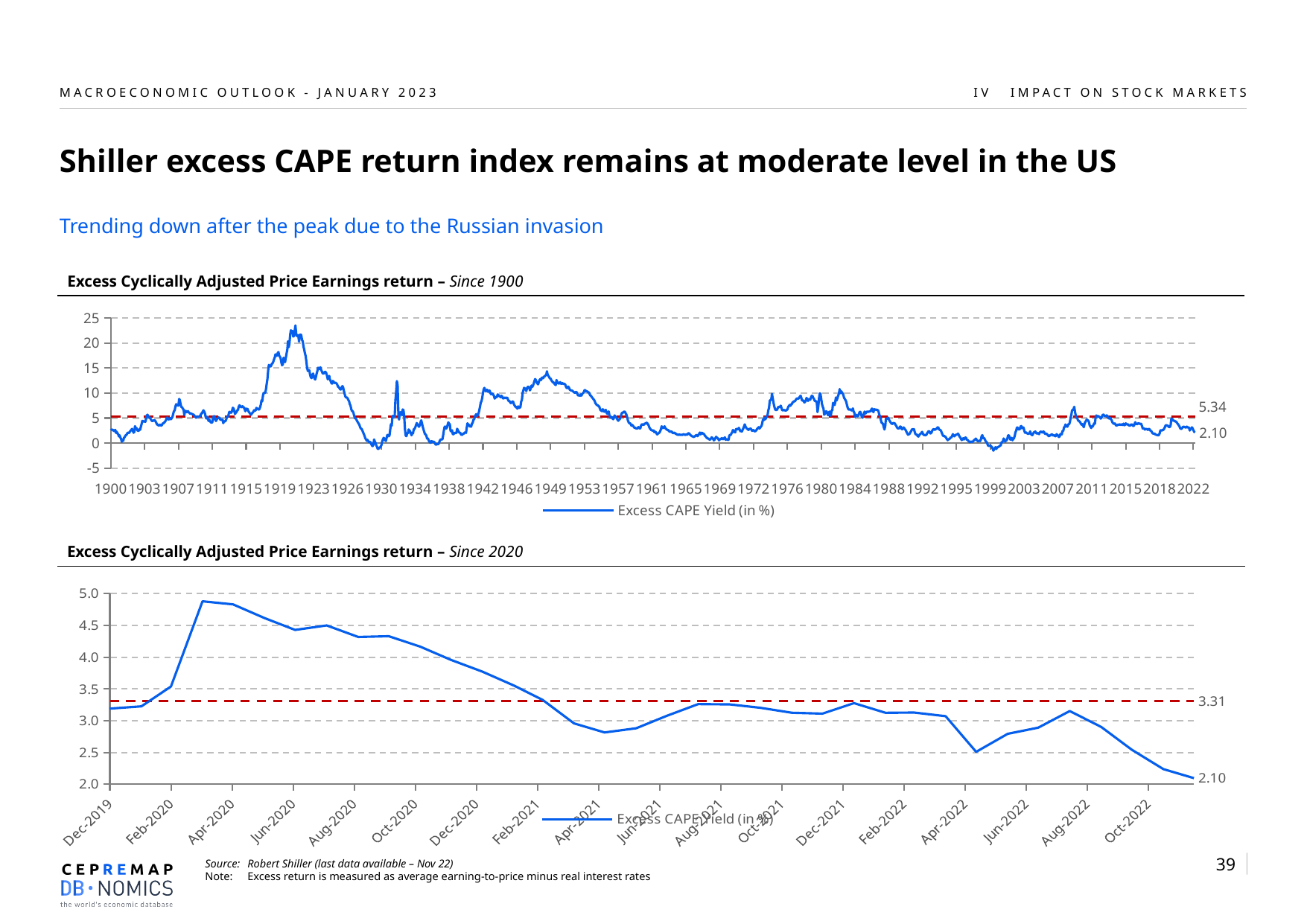
In the 'Since 2020' chart, is the value for Apr-2020 greater or less than 4.5? greater In the 'Since 1900' chart, what is the value of the red dashed horizontal line labelled at the right edge? 5.34 In the 'Since 2020' chart, is the value for Apr-2021 greater or less than 3.0? less In the 'Since 2020' chart, what is the last value of the Excess CAPE Yield labelled at the right end of the line? 2.10 In the 'Since 2020' chart, what is the value of the red dashed horizontal line labelled at the right edge? 3.31 What kind of chart is the 'Excess Cyclically Adjusted Price Earnings return – Since 1900' chart? Line chart In the 'Since 1900' chart, is the peak value of the Excess CAPE Yield around 1921 greater or less than 20? greater What is the legend entry of the 'Since 1900' chart? Excess CAPE Yield (in %) In the 'Since 1900' chart, what is the latest value of the Excess CAPE Yield labelled at the right end of the line? 2.10 In the 'Since 2020' chart, does the Excess CAPE Yield rise or fall between Apr-2020 and Dec-2020? Fall In the 'Since 2020' chart, which is larger: the value for Dec-2019 or the value for Apr-2020? Apr-2020 How many series does the legend of the 'Since 2020' chart list? 1